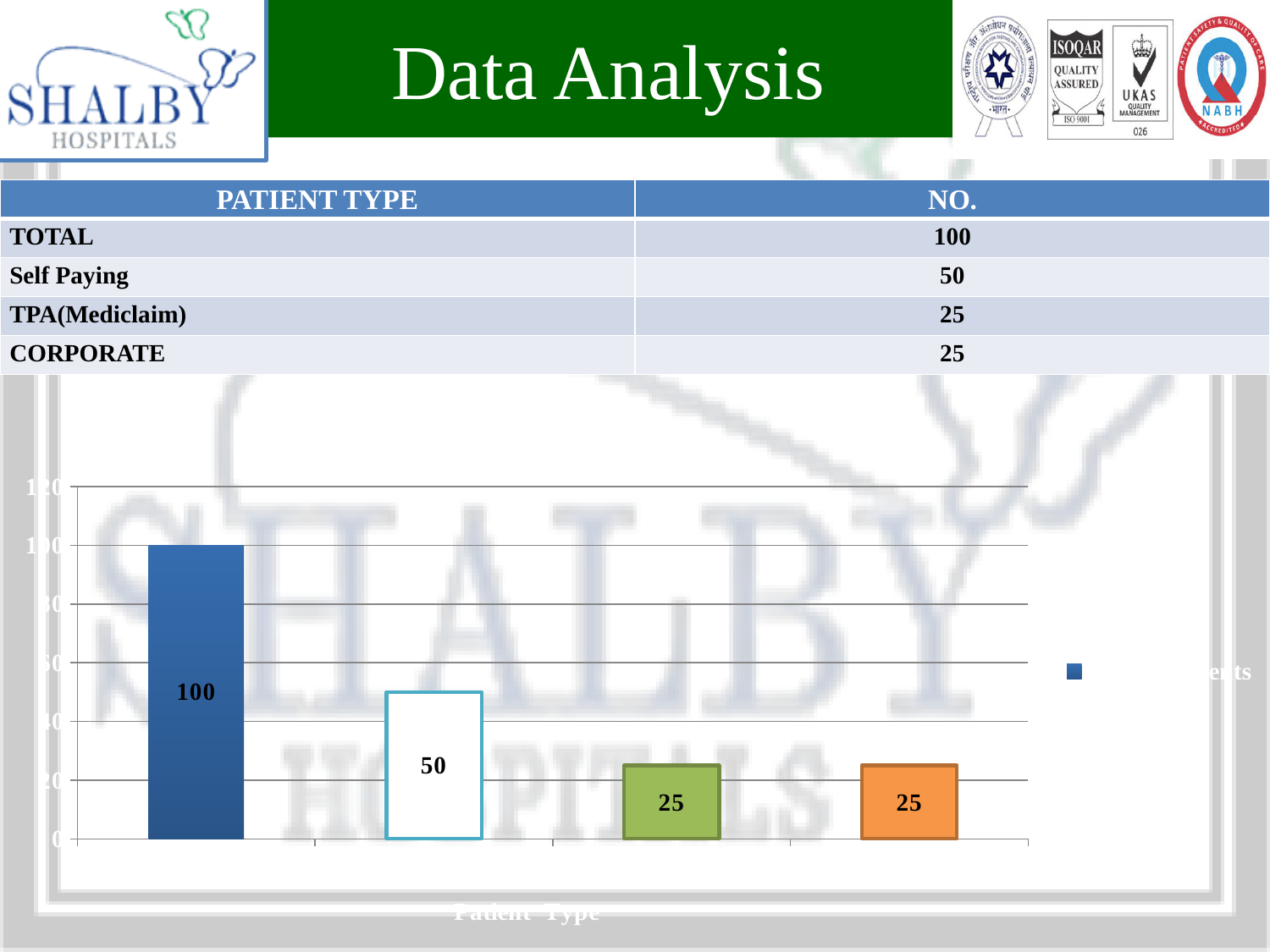
What type of chart is shown on the slide? Bar chart What is the value shown on the second (white) bar of the chart? 50 What is the difference between the value of the dark blue bar and the white bar? 50 Which is larger, the value of the white bar or the green bar? The white bar (50) How many bars are plotted in the chart? 4 Do the bar values rise or fall from left to right across the chart? Fall Which bar in the chart has the highest value? The first (dark blue) bar, 100 What is the value shown on the first (dark blue) bar of the chart? 100 What is the value shown on the orange bar of the chart? 25 What is the value shown on the green bar of the chart? 25 Is the value of the dark blue bar greater or less than 80? greater